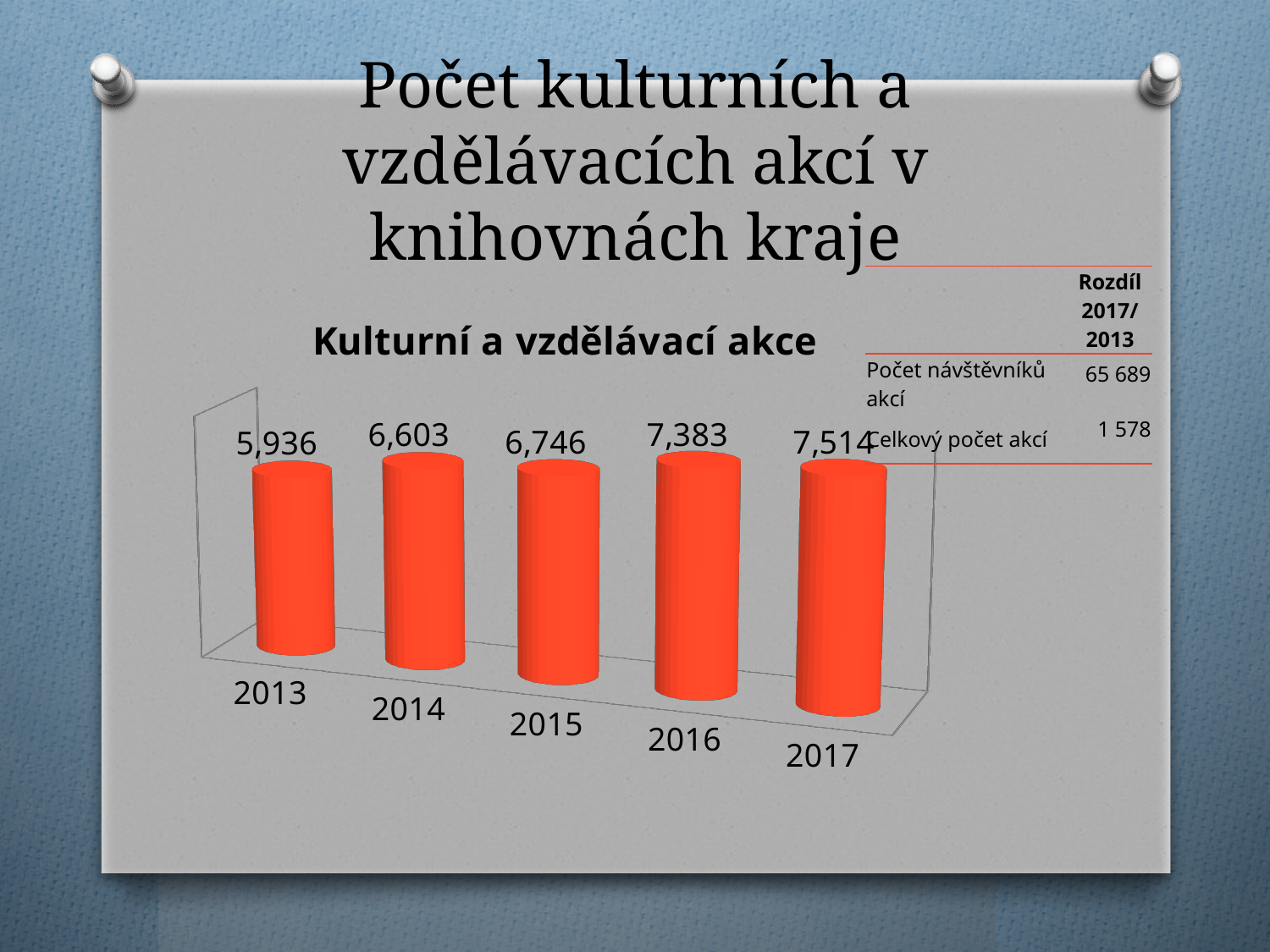
Which year has the lowest value in the chart? 2013 What is the difference between the values for 2016 and 2014? 780 Do the values rise or fall from 2013 to 2017? rise How many years are shown in the chart? 5 What is the value for 2015 in the chart? 6,746 What is the value for 2013 in the chart? 5,936 What kind of chart is shown on the slide? bar chart Which is larger, the value for 2014 or the value for 2016? 2016 What is the difference between the values for 2015 and 2013? 810 Which year has the highest value in the chart? 2017 What is the title of the chart? Kulturní a vzdělávací akce What is the value for 2016 in the chart? 7,383